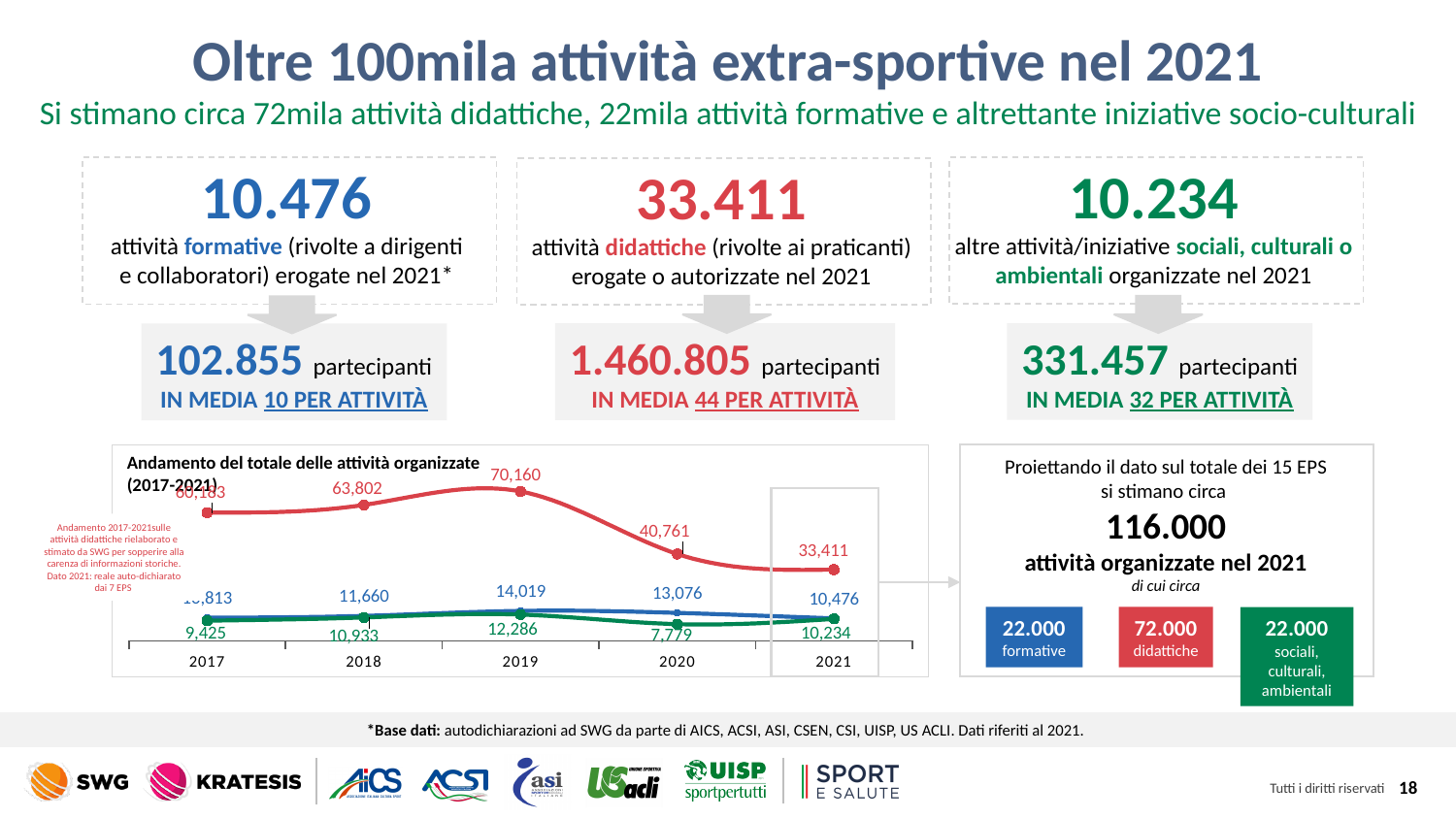
What is the value of the red line in 2019 in the chart 'Andamento del totale delle attività organizzate (2017-2021)'? 70,160 In which year does the green line reach its lowest value in the line chart? 2020 What is the value of the red line in 2021 in the line chart? 33,411 In the line chart, which is larger in 2021: the blue line's value or the green line's value? The blue line (10,476) What is the value of the blue line in 2019 in the line chart? 14,019 What type of chart is 'Andamento del totale delle attività organizzate (2017-2021)'? Line chart In which year does the red line reach its highest value in the line chart? 2019 How many years are shown on the x axis of the line chart? 5 Does the red line rise or fall between 2019 and 2021 in the line chart? Fall What is the difference between the red line's values in 2019 and 2020 in the line chart? 29,399 What is the title of the line chart on the slide? Andamento del totale delle attività organizzate (2017-2021) What is the value of the green line in 2020 in the line chart? 7,779